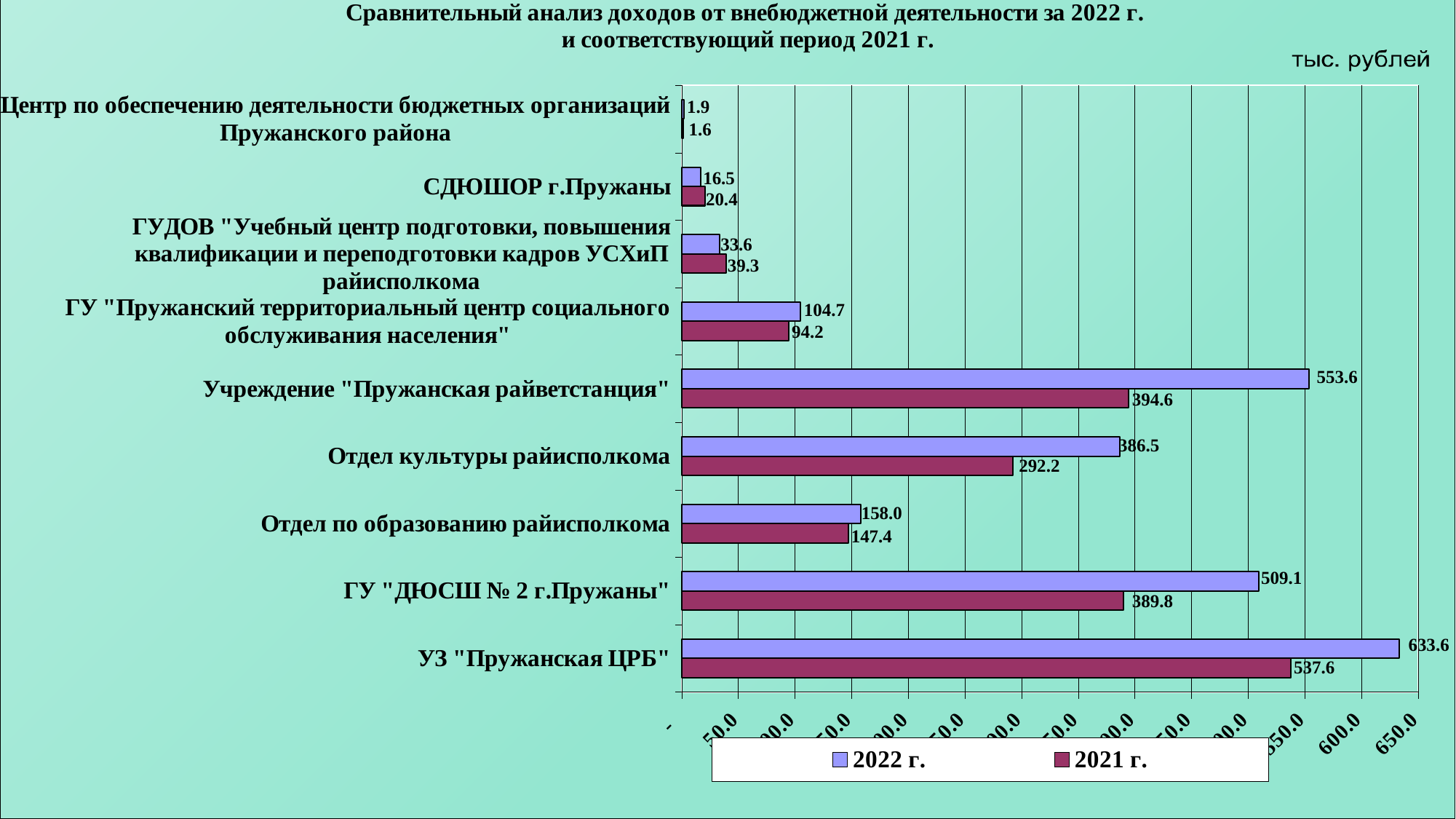
What is the 2021 г. value for Отдел культуры райисполкома? 292.2 What is the 2022 г. value for ГУ "ДЮСШ № 2 г.Пружаны"? 509.1 What is the difference between the 2022 г. and 2021 г. values for Учреждение "Пружанская райветстанция"? 159.0 For СДЮШОР г.Пружаны, which is larger: the 2022 г. value or the 2021 г. value? 2021 г. What is the 2022 г. value for УЗ "Пружанская ЦРБ"? 633.6 How many series does the legend list? 2 What type of chart is shown on the slide? bar chart Which organisation has the highest 2022 г. value? УЗ "Пружанская ЦРБ" Is the 2021 г. value for ГУ "ДЮСШ № 2 г.Пружаны" greater or less than 400.0? less Which organisation has the lowest 2021 г. value? Центр по обеспечению деятельности бюджетных организаций Пружанского района What unit is indicated above the chart? тыс. рублей How many organisations (categories) are shown on the chart? 9